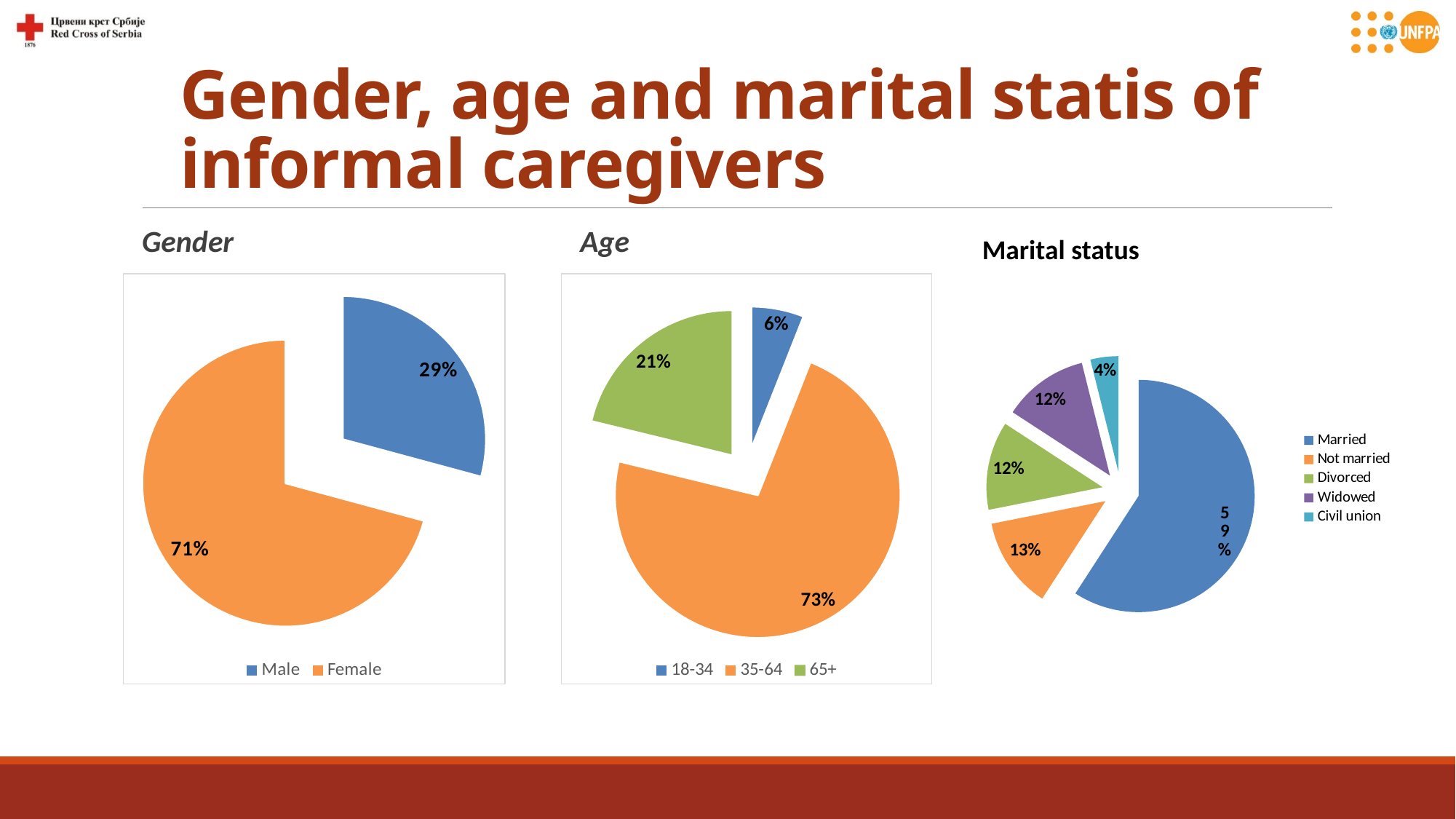
What type of chart is used for the Gender chart? Pie chart In the Marital status chart, what share of caregivers are married? 59% In the Marital status chart, which is larger: Not married or Widowed? Not married In the Age chart, what share of caregivers are aged 35-64? 73% In the Age chart, which age group has the smallest share? 18-34 How many age groups does the legend of the Age chart list? 3 In the Gender chart, what percentage of informal caregivers are male? 29% How many categories does the legend of the Marital status chart list? 5 In the Age chart, what is the difference between the 65+ share and the 18-34 share? 15% In the Marital status chart, which category has the smallest share? Civil union In the Gender chart, what percentage of informal caregivers are female? 71% In the Gender chart, what is the difference between the Female and Male shares? 42%